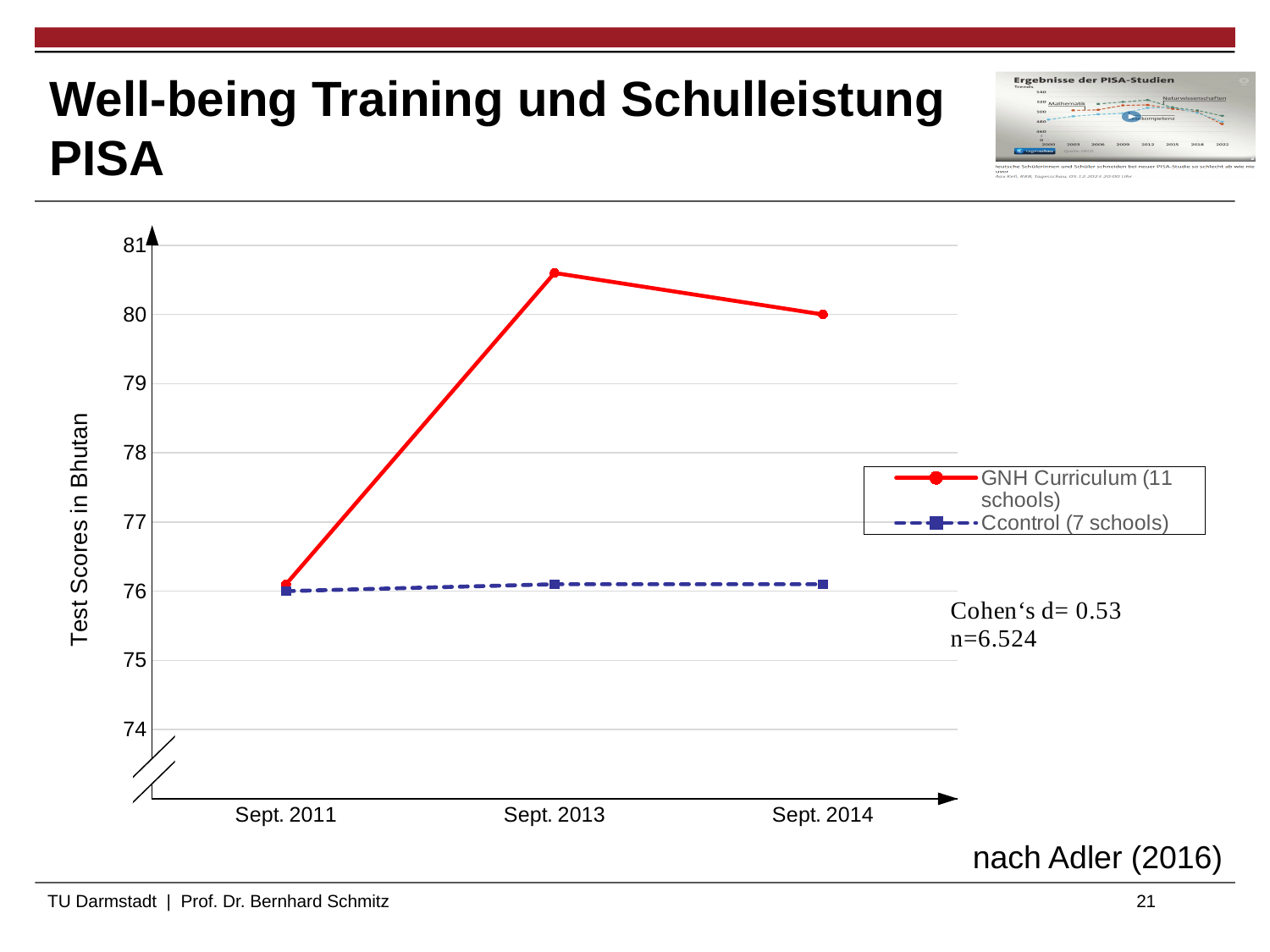
At which time point does the GNH Curriculum (11 schools) series reach its highest value? Sept. 2013 Is the value for GNH Curriculum (11 schools) at Sept. 2011 greater or less than 77? less Is the value for Ccontrol (7 schools) at Sept. 2014 greater or less than 77? less How many series does the chart legend list? 2 How many time points are shown on the x axis of the chart? 3 Does the GNH Curriculum (11 schools) series rise or fall between Sept. 2013 and Sept. 2014? fall What kind of chart is shown on the slide? line chart At which time point is the GNH Curriculum (11 schools) series at its lowest value? Sept. 2011 Is the value for GNH Curriculum (11 schools) at Sept. 2013 greater or less than 80? greater At Sept. 2013, which series has the higher value, GNH Curriculum (11 schools) or Ccontrol (7 schools)? GNH Curriculum (11 schools) What is the label of the y axis of the chart? Test Scores in Bhutan Does the GNH Curriculum (11 schools) series rise or fall between Sept. 2011 and Sept. 2013? rise